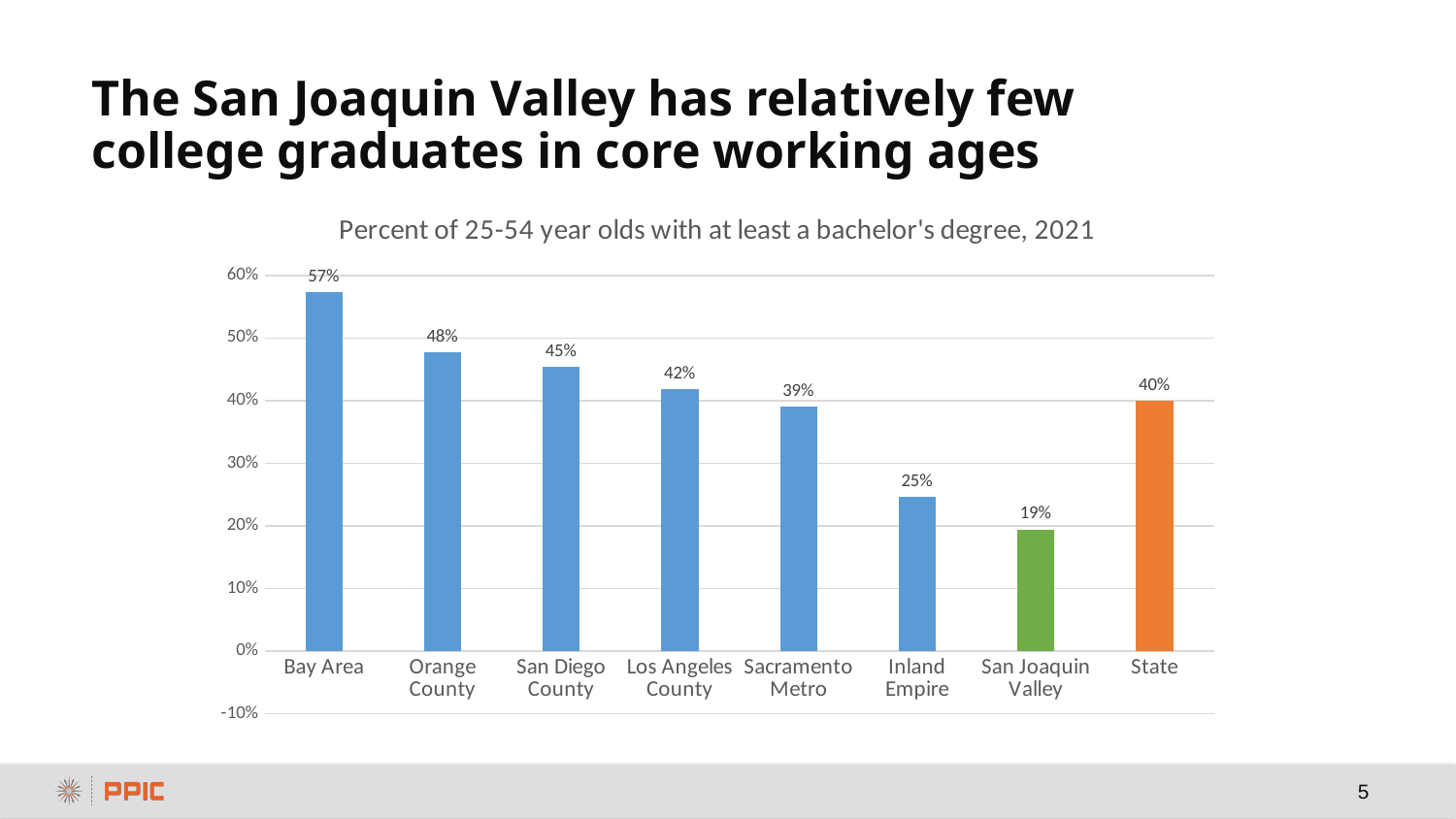
What is the value for the San Joaquin Valley? 19% What is the value for the Inland Empire? 25% What is the value for the Bay Area? 57% What is the value for the State? 40% Which region has the lowest percent of 25-54 year olds with at least a bachelor's degree? San Joaquin Valley What is the difference between the State value and the San Joaquin Valley value? 21 percentage points Which is larger, the value for Sacramento Metro or the value for the State? State What is the title of the chart? Percent of 25-54 year olds with at least a bachelor's degree, 2021 How many categories are shown on the x axis? 8 What is the difference between the Bay Area and Orange County values? 9 percentage points Which region has the highest percent of 25-54 year olds with at least a bachelor's degree? Bay Area What kind of chart is shown on the slide? Bar chart